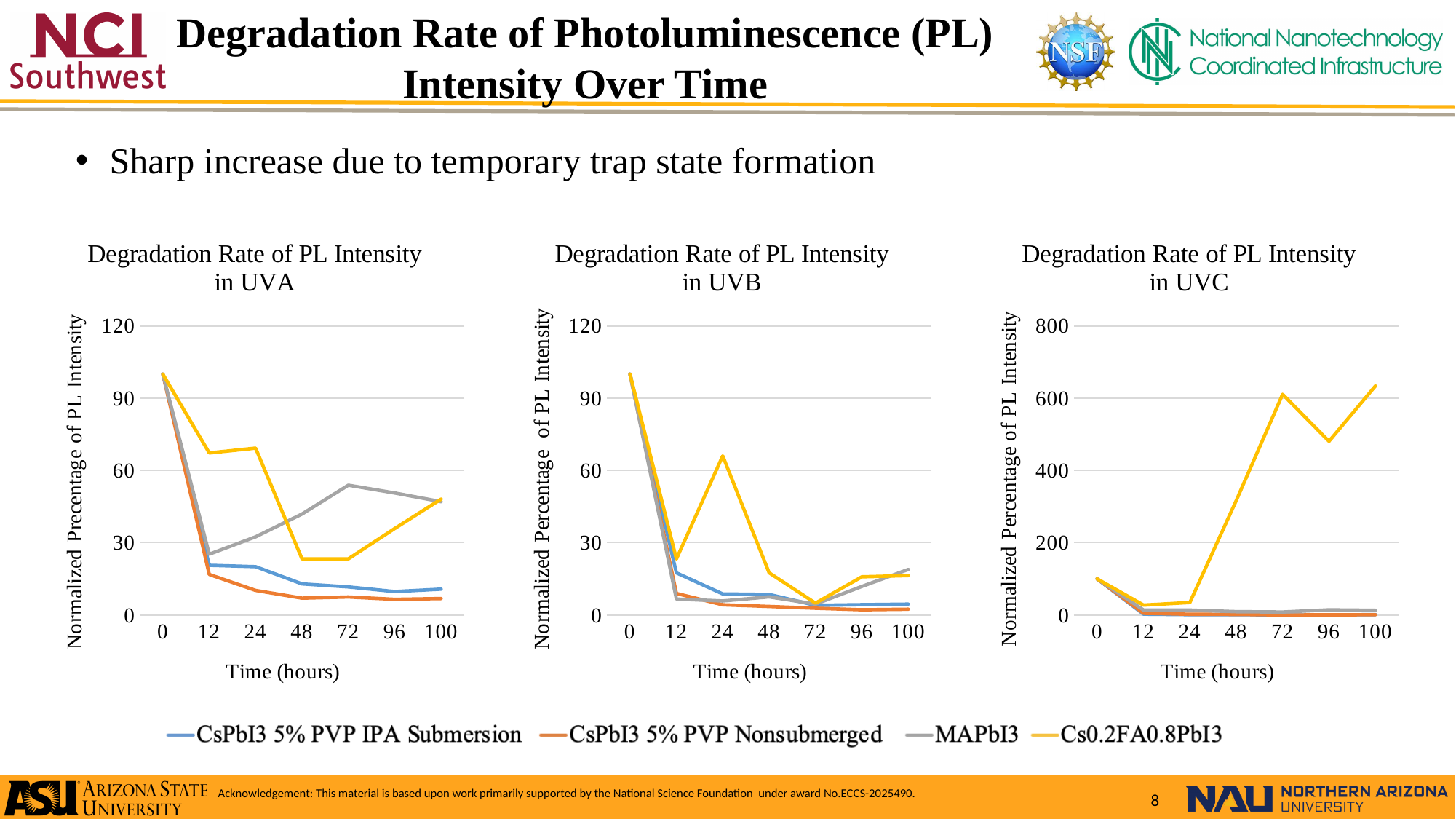
What is the y-axis label of the "Degradation Rate of PL Intensity in UVC" chart? Normalized Percentage of PL Intensity In the "Degradation Rate of PL Intensity in UVA" chart, does the CsPbI3 5% PVP Nonsubmerged series generally rise or fall from 0 to 100 hours? fall What kind of chart is the "Degradation Rate of PL Intensity in UVA" chart? line chart In the "Degradation Rate of PL Intensity in UVA" chart, which series has the highest value at 72 hours? MAPbI3 In the "Degradation Rate of PL Intensity in UVC" chart, is the value for Cs0.2FA0.8PbI3 at 96 hours greater or less than 400? greater How many series does the legend list for the charts on the slide? 4 In the "Degradation Rate of PL Intensity in UVB" chart, how many time points are shown on the x axis? 7 In the "Degradation Rate of PL Intensity in UVA" chart, is the value for Cs0.2FA0.8PbI3 at 12 hours greater or less than 60? greater In the "Degradation Rate of PL Intensity in UVA" chart, which is larger at 48 hours: MAPbI3 or Cs0.2FA0.8PbI3? MAPbI3 In the "Degradation Rate of PL Intensity in UVA" chart, is the value for CsPbI3 5% PVP IPA Submersion at 12 hours greater or less than 30? less In the "Degradation Rate of PL Intensity in UVC" chart, which series has the highest value at 100 hours? Cs0.2FA0.8PbI3